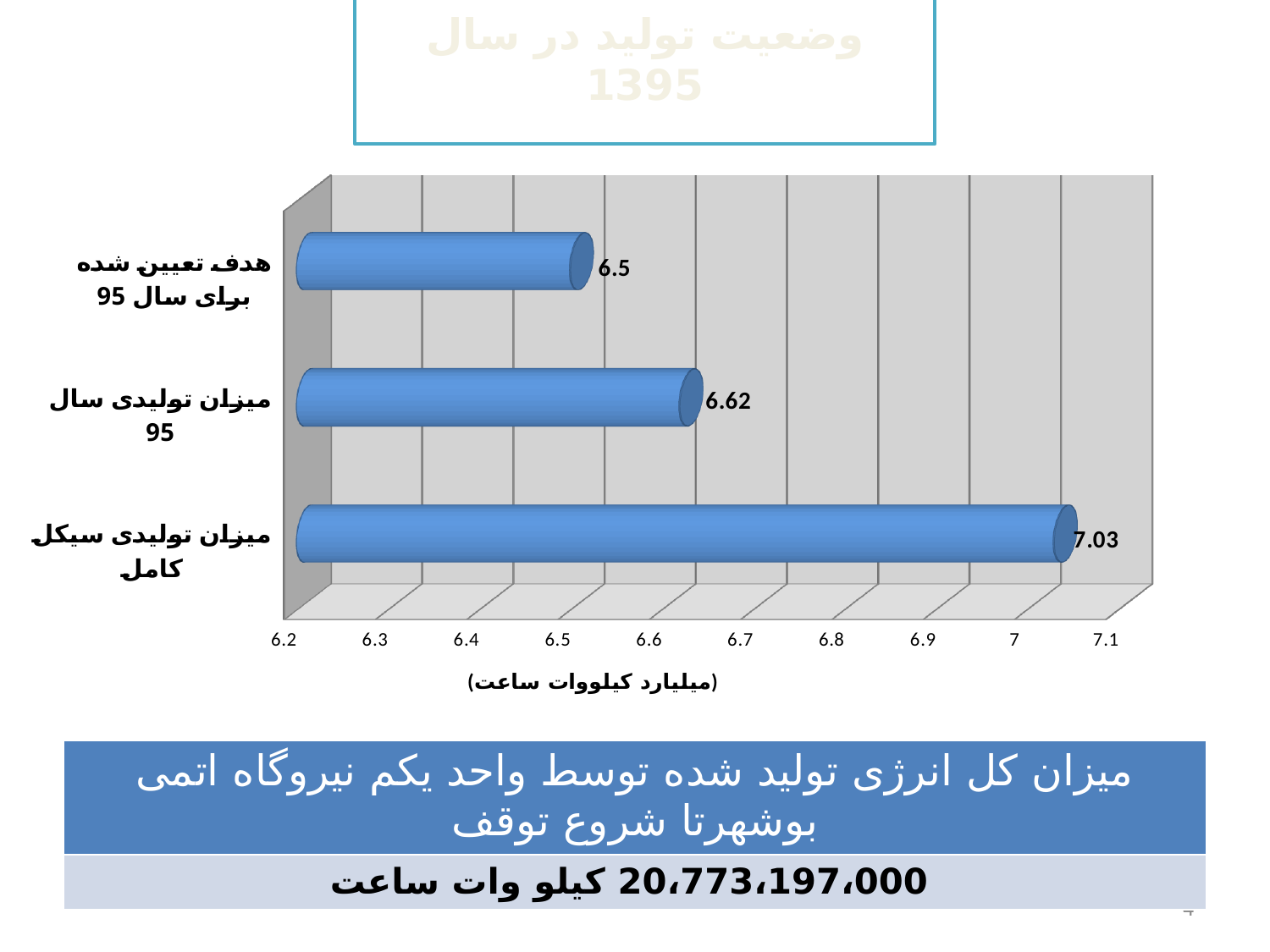
Which is larger: the value for "میزان تولیدی سال 95" or the value for "هدف تعیین شده برای سال 95"? میزان تولیدی سال 95 What is the difference between the value for "میزان تولیدی سال 95" and the value for "هدف تعیین شده برای سال 95"? 0.12 How many categories are shown in the chart? 3 What is the value for "هدف تعیین شده برای سال 95"? 6.5 What is the difference between the value for "میزان تولیدی سیکل کامل" and the value for "میزان تولیدی سال 95"? 0.41 Which category has the highest value? میزان تولیدی سیکل کامل What is the value for "میزان تولیدی سال 95"? 6.62 Is the value for "میزان تولیدی سیکل کامل" greater or less than 7? greater Which category has the lowest value? هدف تعیین شده برای سال 95 What unit is given in the x-axis label of the chart? میلیارد کیلووات ساعت What is the value for "میزان تولیدی سیکل کامل"? 7.03 What kind of chart is shown on the slide? bar chart